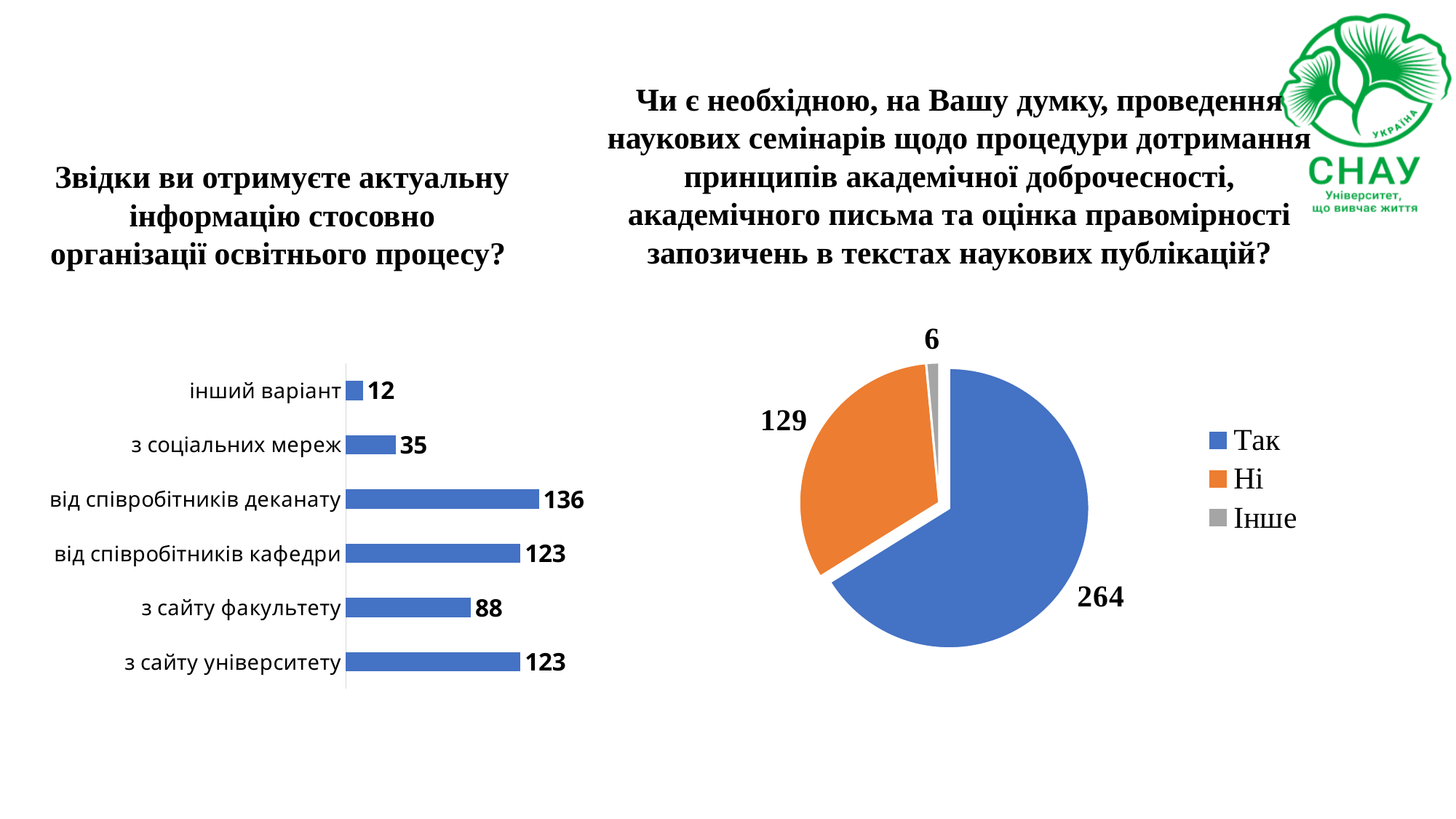
In the bar chart on the left, what is the difference between 'від співробітників деканату' and 'з соціальних мереж'? 101 In the pie chart on the right, what is the value for 'Так'? 264 In the pie chart on the right, which colour represents 'Ні'? orange How many categories are shown in the bar chart on the left? 6 In the bar chart on the left, what is the value for 'від співробітників деканату'? 136 In the bar chart on the left, which category has the lowest value? інший варіант How many entries does the legend of the pie chart on the right list? 3 What type of chart is the chart on the left? bar chart In the bar chart on the left, which category has the highest value? від співробітників деканату In the bar chart on the left, which is larger: 'з сайту факультету' or 'з сайту університету'? з сайту університету In the bar chart on the left, what is the value for 'з сайту факультету'? 88 In the pie chart on the right, what is the difference between 'Так' and 'Ні'? 135